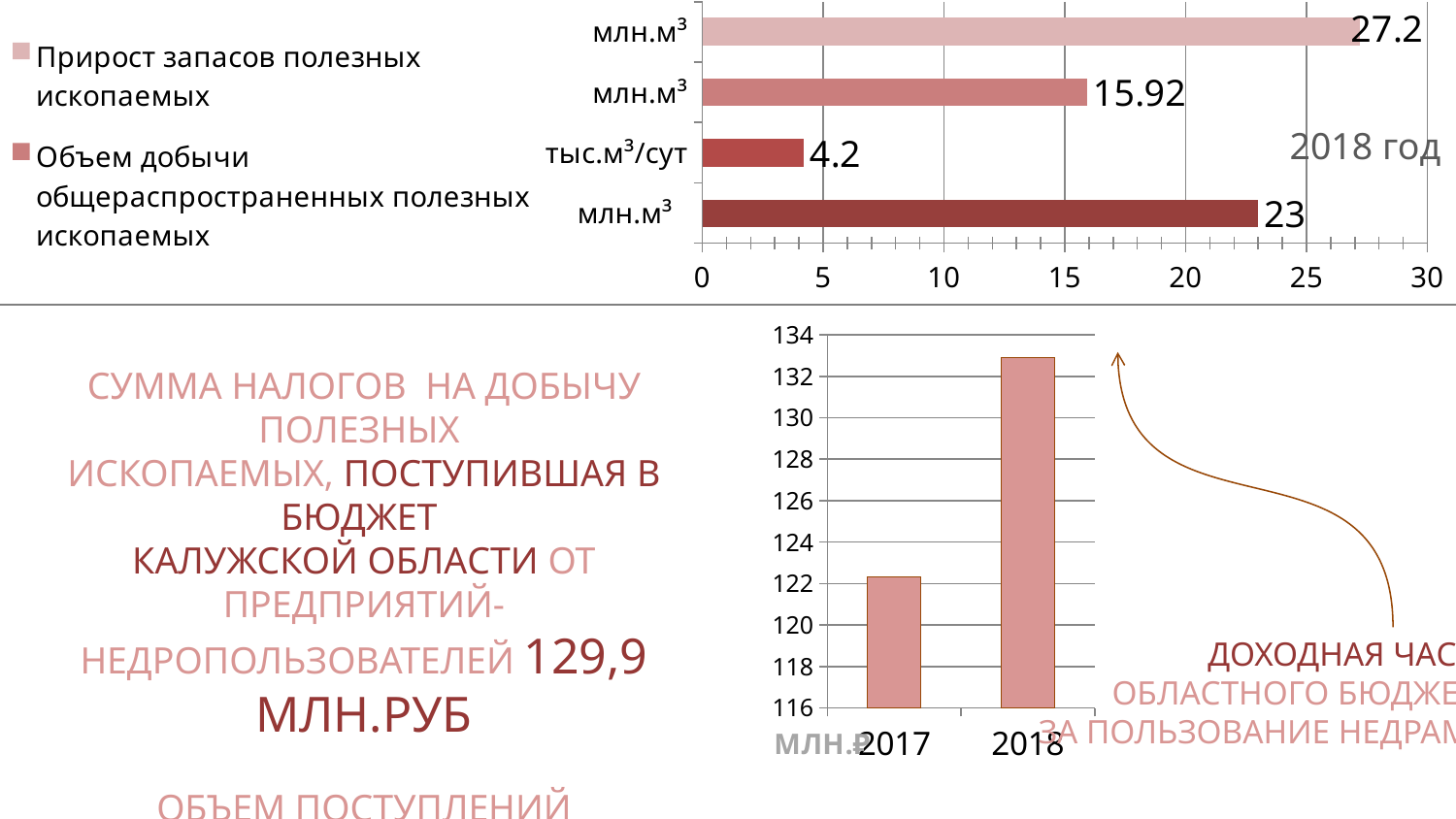
In the top bar chart, what is the difference between the topmost bar and the bottom bar? 4.2 In the bottom bar chart, is the value for 2018 greater or less than 130? greater In the bottom bar chart, do the values rise or fall from 2017 to 2018? Rise In the top bar chart, what is the value of the bar labelled тыс.м³/сут? 4.2 What type of chart is the chart in the bottom half of the slide? Bar chart In the top bar chart, how many bars are plotted? 4 In the top bar chart, which bar has the highest value? The topmost bar (27.2) In the top bar chart, how many entries does the legend list? 2 In the top bar chart, what is the value of the bottom bar? 23 In the top bar chart, which bar has the lowest value? The bar labelled тыс.м³/сут (4.2) In the top bar chart, what is the value of the second bar from the top? 15.92 In the top bar chart, what is the value of the topmost bar? 27.2